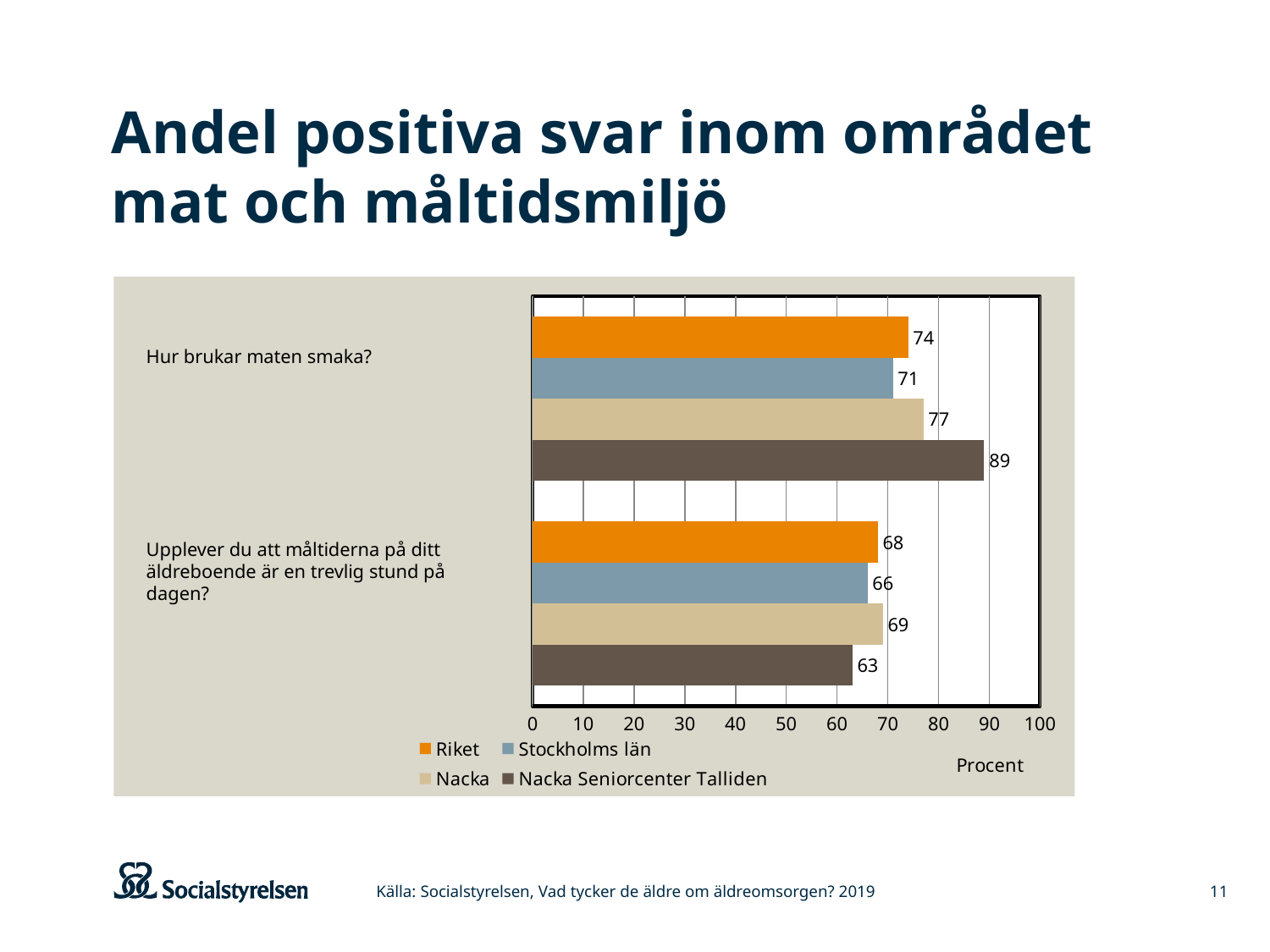
How many question categories are shown on the chart? 2 How many series does the legend list? 4 What is the value for Nacka Seniorcenter Talliden for "Hur brukar maten smaka?"? 89 What is the label of the horizontal axis? Procent Which is larger for "Hur brukar maten smaka?": Riket or Nacka? Nacka What kind of chart is shown on the slide? Bar chart What is the difference between the Nacka Seniorcenter Talliden values for the two questions? 26 Is the value for Nacka Seniorcenter Talliden for "Hur brukar maten smaka?" greater or less than 80? greater Which series has the lowest value for "Upplever du att måltiderna på ditt äldreboende är en trevlig stund på dagen?"? Nacka Seniorcenter Talliden What is the value for Stockholms län for "Hur brukar maten smaka?"? 71 What is the value for Riket for "Upplever du att måltiderna på ditt äldreboende är en trevlig stund på dagen?"? 68 Which series has the highest value for "Hur brukar maten smaka?"? Nacka Seniorcenter Talliden